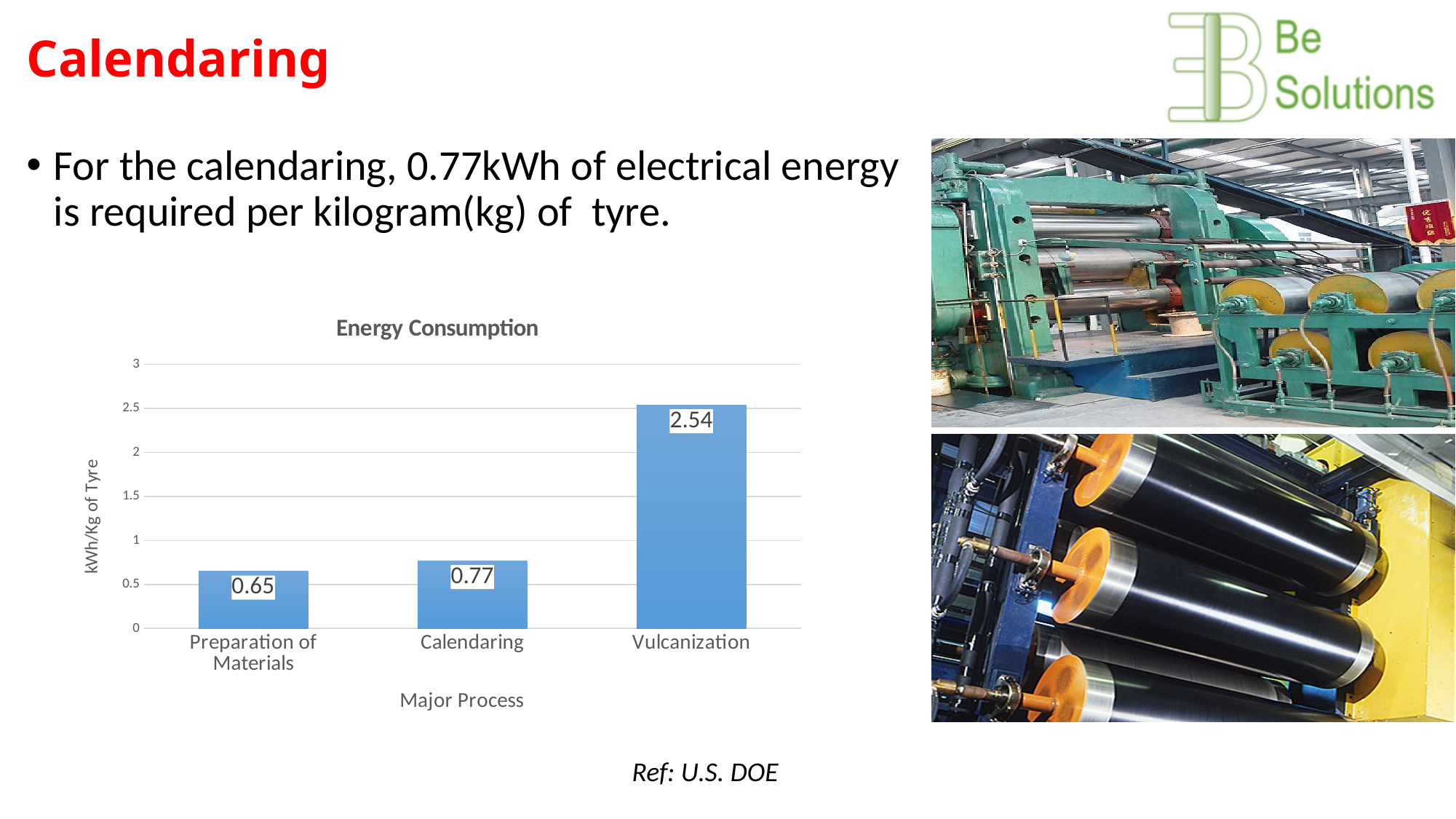
What is the energy consumption value for Calendaring? 0.77 How many processes are shown in the chart? 3 Is the value for Vulcanization greater or less than 2? greater Which process has the highest energy consumption? Vulcanization What is the difference in energy consumption between Vulcanization and Calendaring? 1.77 What type of chart is shown on the slide? Bar chart Which has a higher energy consumption, Calendaring or Preparation of Materials? Calendaring What is the energy consumption value for Vulcanization? 2.54 Which process has the lowest energy consumption? Preparation of Materials What is the title of the chart? Energy Consumption What is the difference in energy consumption between Calendaring and Preparation of Materials? 0.12 What is the energy consumption value for Preparation of Materials? 0.65